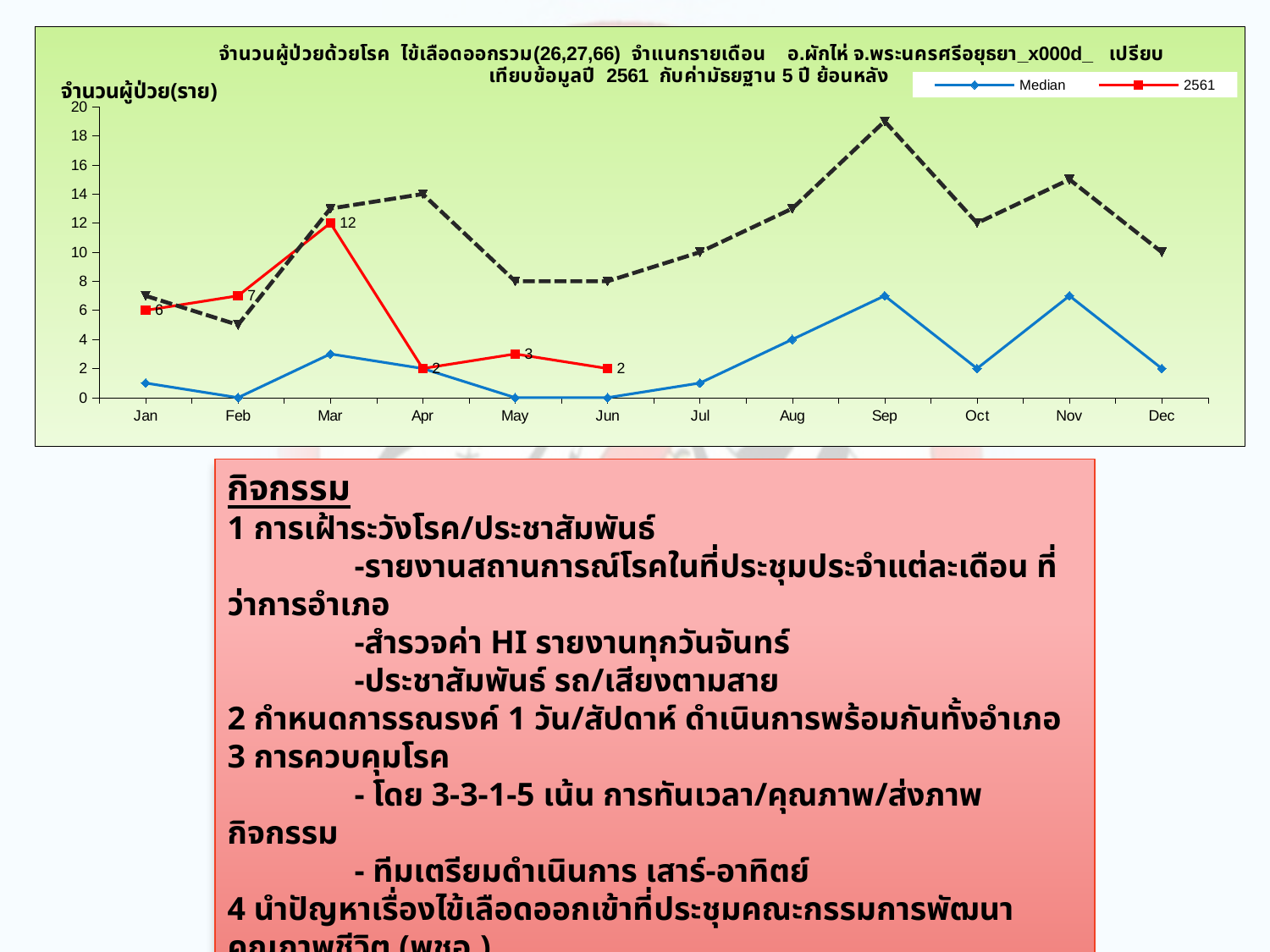
How many months are shown on the x axis? 12 What type of chart is shown on the slide? Line chart What is the value of the 2561 series in May? 3 In which month does the 2561 series reach its highest value? Mar What is the value of the 2561 series in Jan? 6 What is the value of the 2561 series in Mar? 12 Is the value of the black dashed line in Sep greater or less than 18? greater Which month has the larger 2561 value, Jan or Feb? Feb What is the difference between the 2561 values for Mar and Apr? 10 Is the Median value for Sep greater or less than 4? greater How many series does the legend list? 2 How many data points does the 2561 series have? 6